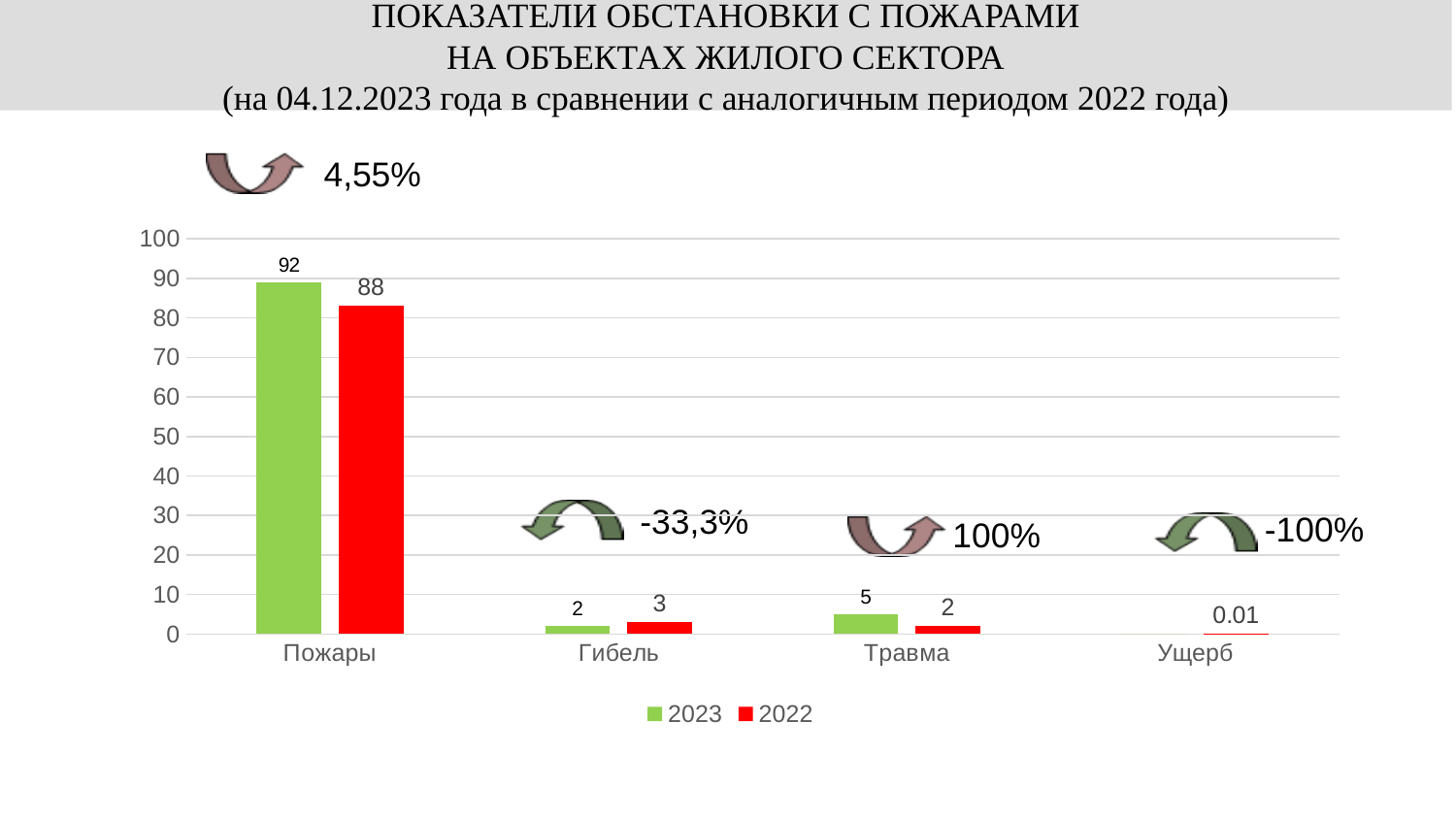
Is the 2022 value for Пожары greater or less than 50? greater What is the value for Травма in the 2023 series? 5 What is the value for Гибель in the 2022 series? 3 How many series does the legend list? 2 What is the value for Пожары in the 2022 series? 88 What is the value for Пожары in the 2023 series? 92 What is the difference between the 2023 and 2022 values for Травма? 3 For Гибель, which series has the larger value, 2023 or 2022? 2022 What is the difference between the 2023 and 2022 values for Пожары? 4 What kind of chart is shown on the slide? Bar chart Which category has the highest value in the 2023 series? Пожары How many categories are shown on the x axis? 4